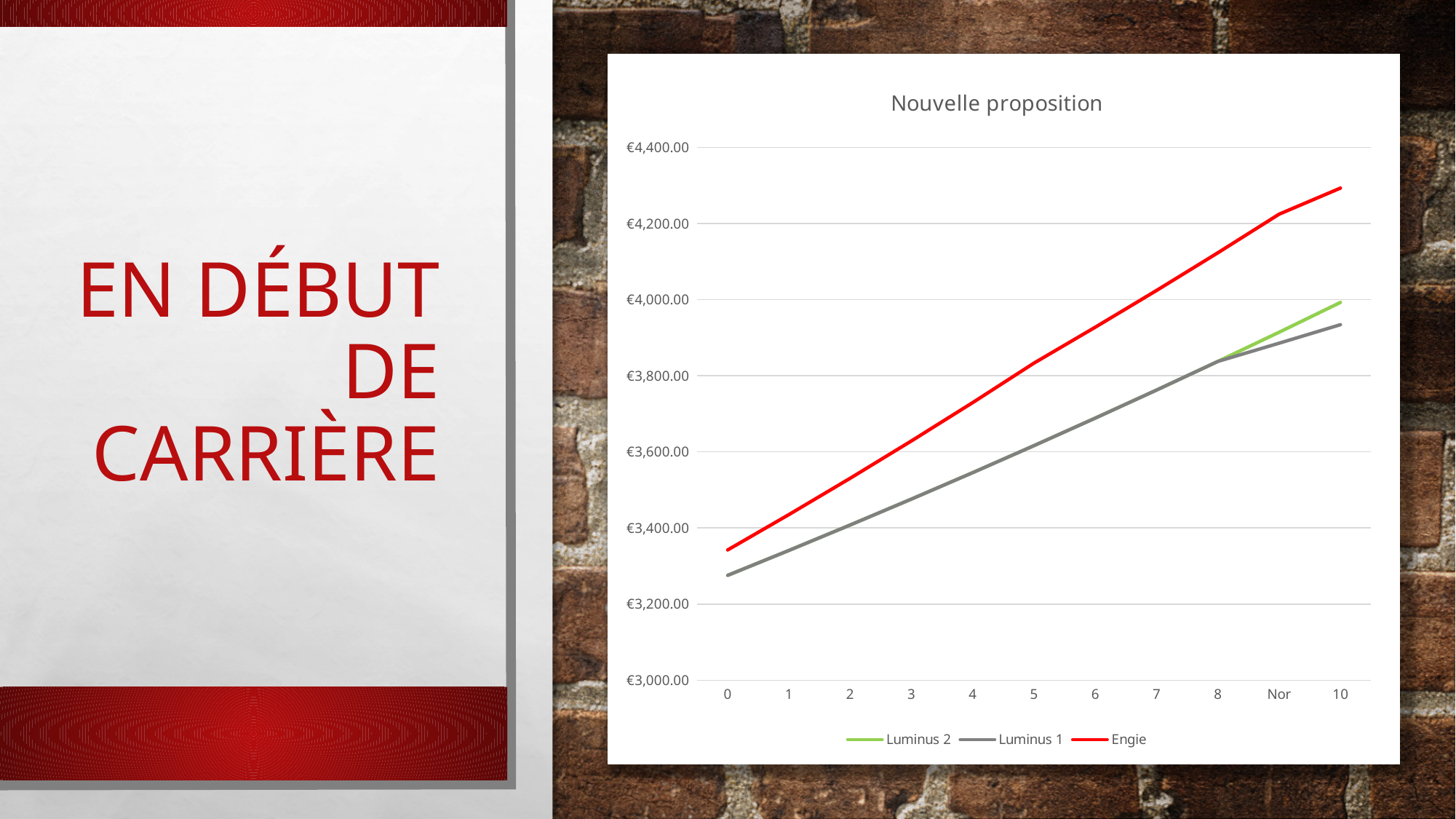
Is the value for Luminus 1 at x = 4 greater or less than €3,600.00? less Is the value for Engie at x = 10 greater or less than €4,200.00? greater Is the value for Engie at x = 0 greater or less than €3,200.00? greater How many points are on the x axis of the chart? 11 Which series has the highest value at x = 10? Engie Which series is drawn in red? Engie What is the title of the chart? Nouvelle proposition What kind of chart is shown on the slide? Line chart Do the values for Engie rise or fall along the x axis? Rise How many series does the legend list? 3 At x = 10, which is larger: Luminus 2 or Luminus 1? Luminus 2